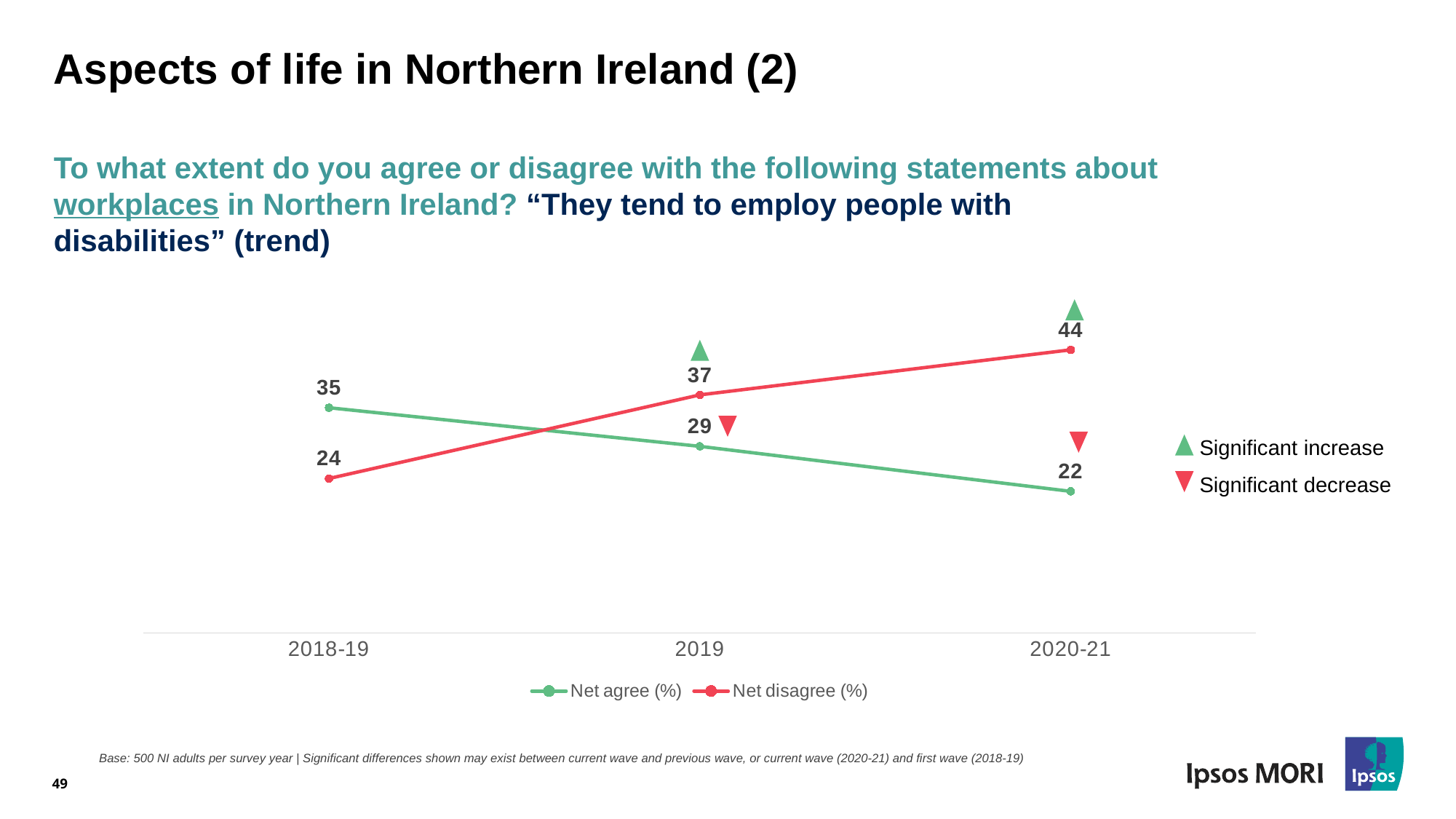
How many series does the legend list? 2 What is the Net agree (%) value for 2018-19? 35 What is the difference between Net disagree (%) and Net agree (%) in 2020-21? 22 What is the Net disagree (%) value for 2018-19? 24 Which is larger in 2018-19, Net agree (%) or Net disagree (%)? Net agree (%) In which year is Net disagree (%) highest? 2020-21 What is the Net disagree (%) value for 2020-21? 44 What is the Net agree (%) value for 2019? 29 In which year is Net agree (%) lowest? 2020-21 Does Net agree (%) rise or fall from 2018-19 to 2020-21? Fall How many survey years are plotted on the x axis? 3 What kind of chart is shown on the slide? Line chart